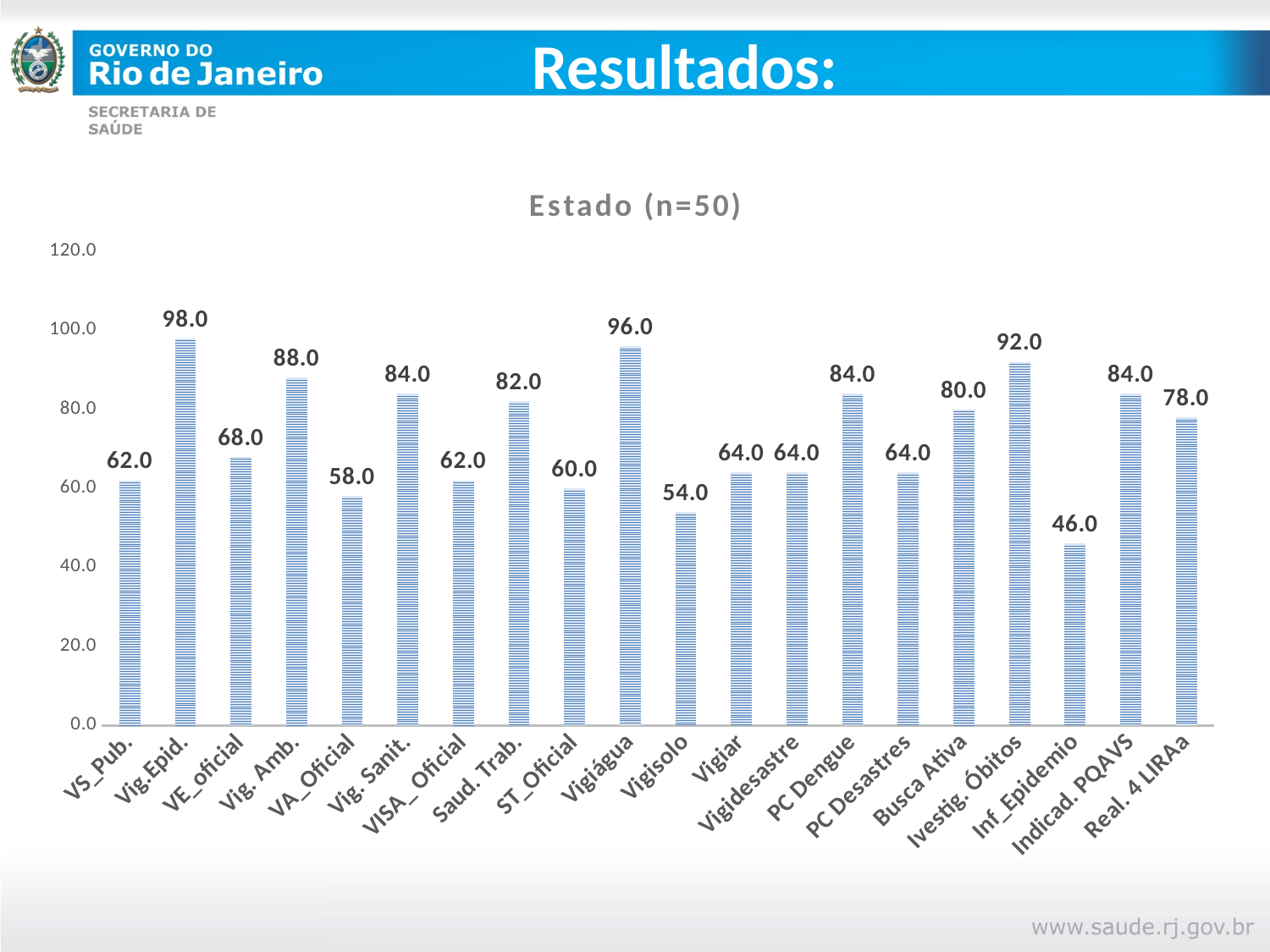
How many categories are shown on the x axis? 20 Which is larger, the value for Vig. Amb. or the value for Saud. Trab.? Vig. Amb. What is the value for Real. 4 LIRAa? 78.0 What is the value for Vig.Epid.? 98.0 What is the title of the chart? Estado (n=50) Which category has the highest value? Vig.Epid. What is the difference between the values for Vig.Epid. and Inf_Epidemio? 52.0 What is the difference between the values for Ivestig. Óbitos and Vigisolo? 38.0 What is the value for Busca Ativa? 80.0 Which category has the lowest value? Inf_Epidemio What is the value for Vigiágua? 96.0 What kind of chart is shown on the slide? Bar chart